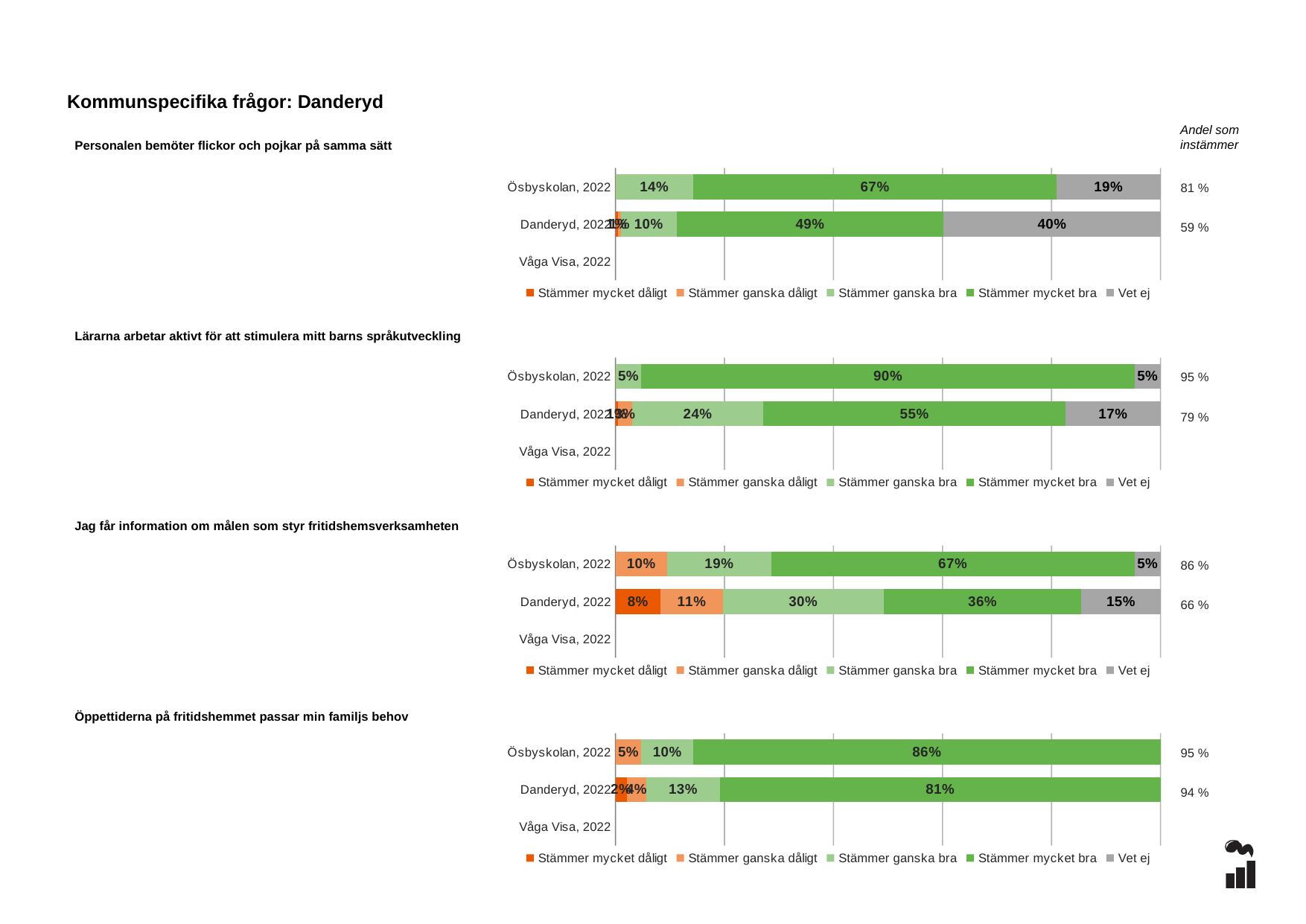
In the chart 'Lärarna arbetar aktivt för att stimulera mitt barns språkutveckling', what is the 'Stämmer ganska bra' value for Danderyd, 2022? 24% What kind of chart is used for 'Lärarna arbetar aktivt för att stimulera mitt barns språkutveckling'? Stacked bar chart In the chart 'Jag får information om målen som styr fritidshemsverksamheten', what is the 'Stämmer mycket dåligt' value for Danderyd, 2022? 8% In the chart 'Jag får information om målen som styr fritidshemsverksamheten', what is the 'Andel som instämmer' value shown for Danderyd, 2022? 66 % In the chart 'Lärarna arbetar aktivt för att stimulera mitt barns språkutveckling', what is the 'Stämmer mycket bra' value for Ösbyskolan, 2022? 90% In the chart 'Öppettiderna på fritidshemmet passar min familjs behov', what is the 'Stämmer ganska bra' value for Danderyd, 2022? 13% In the chart 'Öppettiderna på fritidshemmet passar min familjs behov', which row has the larger 'Stämmer mycket bra' value, Ösbyskolan, 2022 or Danderyd, 2022? Ösbyskolan, 2022 In the chart 'Personalen bemöter flickor och pojkar på samma sätt', what is the 'Vet ej' value for Danderyd, 2022? 40% In the chart 'Jag får information om målen som styr fritidshemsverksamheten', what is the difference between the 'Stämmer mycket bra' values for Ösbyskolan, 2022 and Danderyd, 2022? 31 percentage points How many series does the legend list in the chart 'Personalen bemöter flickor och pojkar på samma sätt'? 5 In the chart 'Personalen bemöter flickor och pojkar på samma sätt', what is the 'Stämmer mycket bra' value for Ösbyskolan, 2022? 67% How many row categories are listed on the y axis of the chart 'Öppettiderna på fritidshemmet passar min familjs behov'? 3